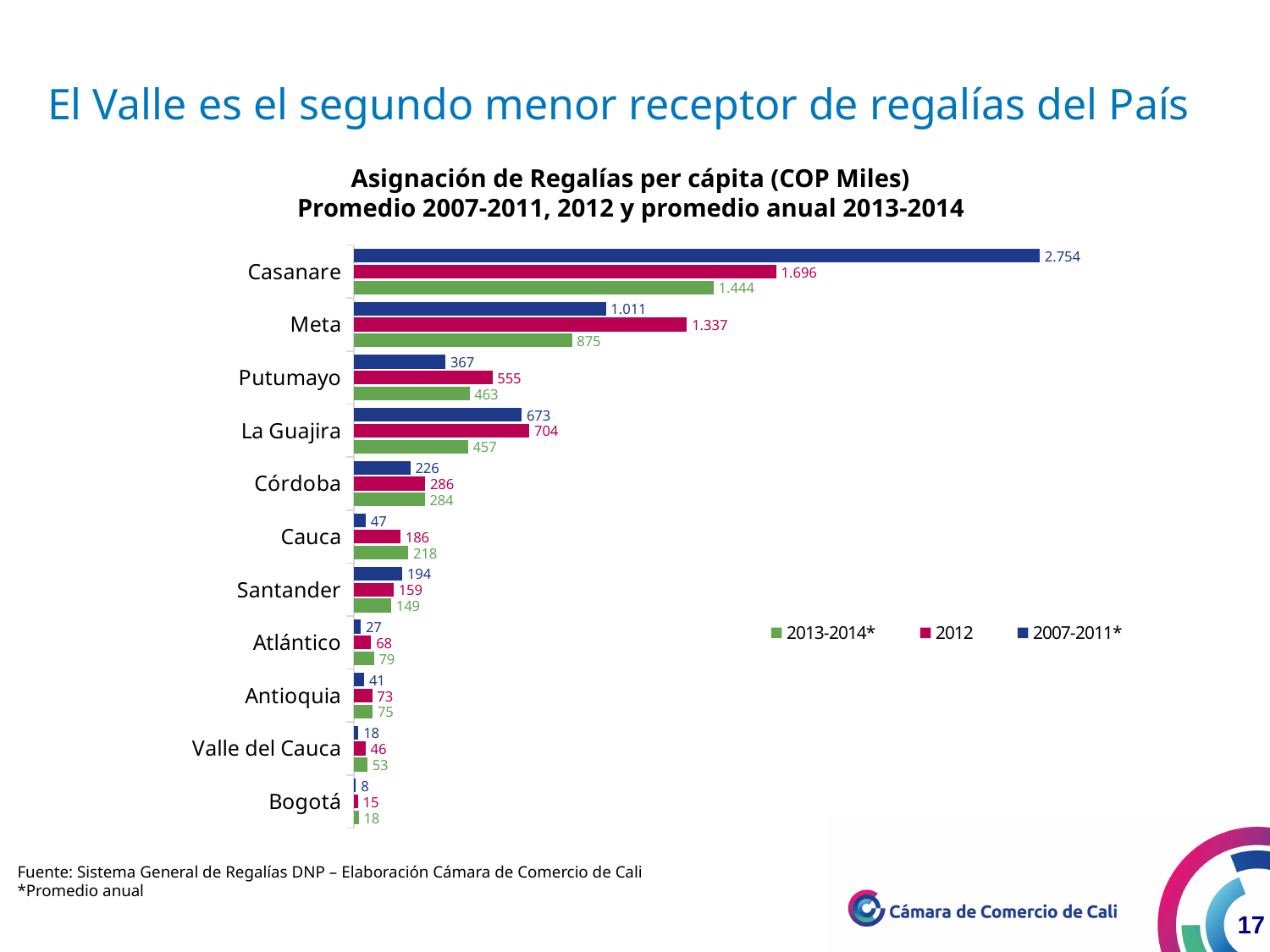
Which is larger for La Guajira, the 2012 value or the 2007-2011* value? 2012 How many series does the legend list? 3 What is the 2007-2011* value for Meta? 1.011 How many departments are shown on the chart? 11 Which department has the highest 2007-2011* value? Casanare What is the difference between the 2012 and 2013-2014* values for Meta? 462 Which department has the lowest 2012 value? Bogotá What is the 2012 value for Casanare? 1.696 What is the difference between the 2007-2011* values for Casanare and Meta? 1.743 What is the 2013-2014* value for Valle del Cauca? 53 Which series is shown in green in the legend? 2013-2014* What kind of chart is shown on the slide? Bar chart